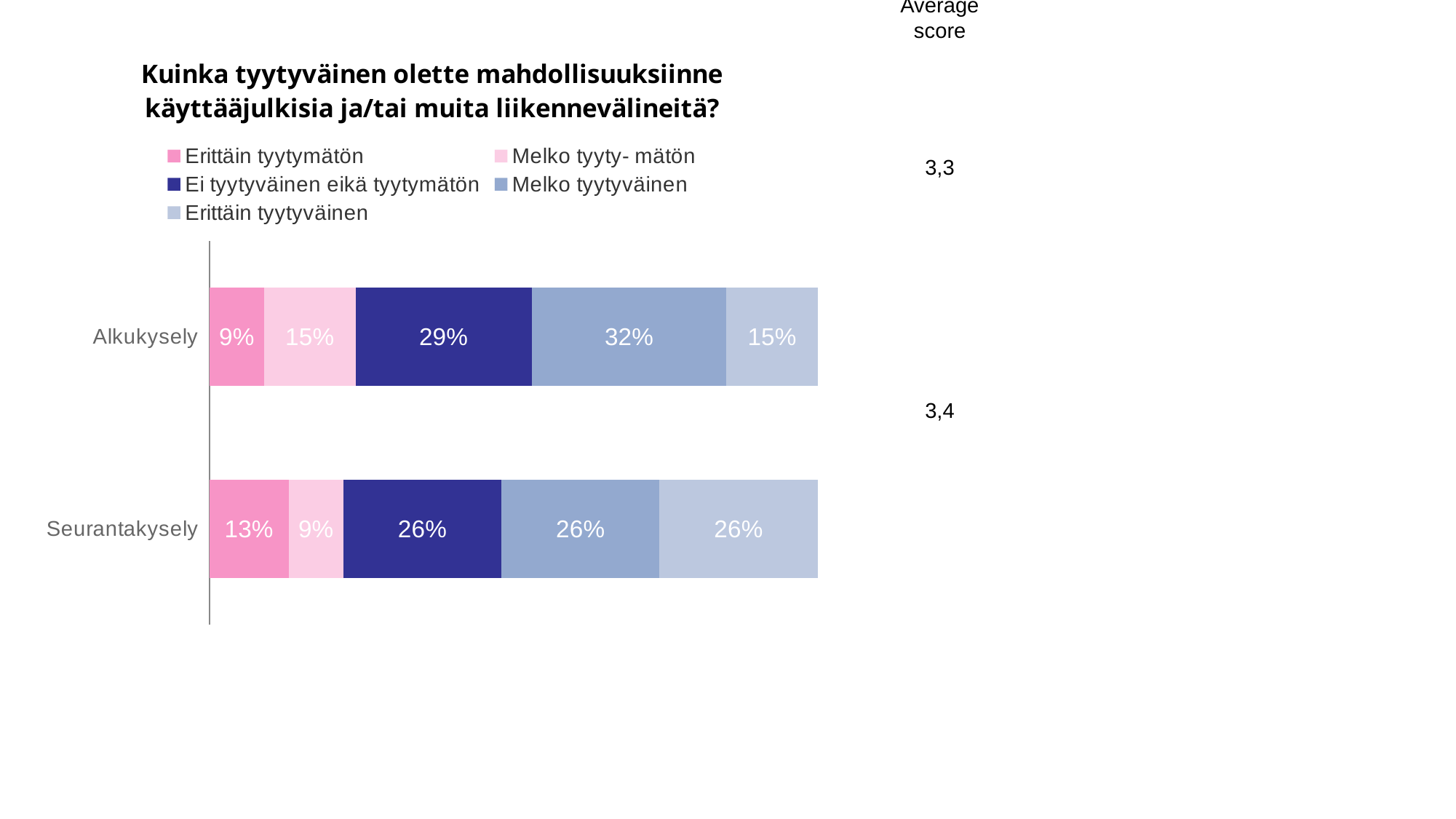
What kind of chart is shown on the slide? Stacked bar chart How many categories (bars) are shown in the chart? 2 What is the value for Melko tyytyväinen in the Alkukysely bar? 32% What is the value for Erittäin tyytymätön in the Alkukysely bar? 9% Which segment is the largest in the Alkukysely bar? Melko tyytyväinen What is the total of the Alkukysely stacked bar? 100% What is the difference between the Erittäin tyytyväinen values for Seurantakysely and Alkukysely? 11% Which segment is the smallest in the Seurantakysely bar? Melko tyyty- mätön Which is larger: Ei tyytyväinen eikä tyytymätön for Alkukysely or for Seurantakysely? Alkukysely What is the value for Melko tyyty- mätön in the Seurantakysely bar? 9% What is the value for Erittäin tyytyväinen in the Seurantakysely bar? 26% How many series does the legend list? 5